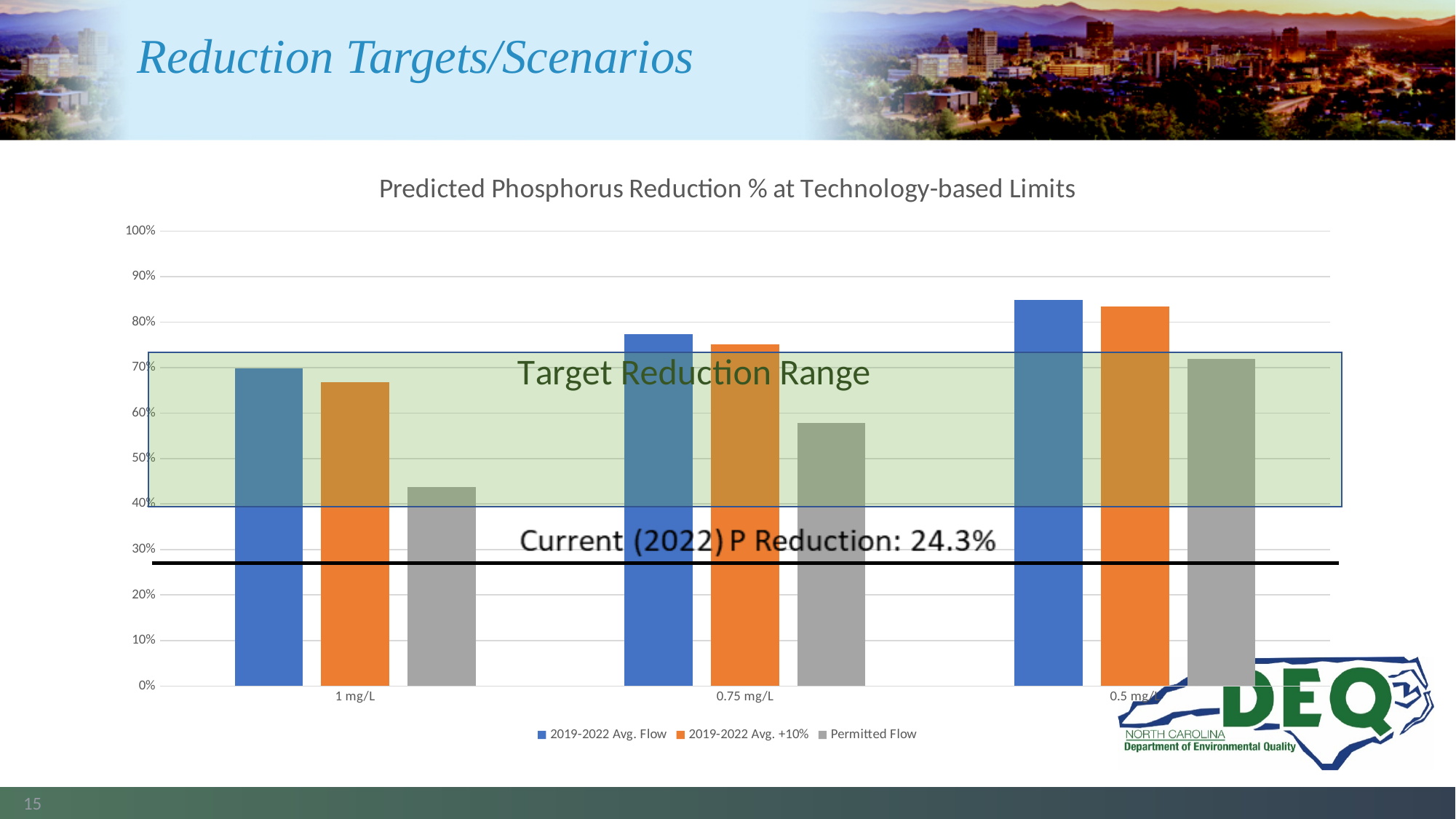
Is the Permitted Flow value at 0.5 mg/L greater or less than 60%? greater Is the 2019-2022 Avg. Flow value at 1 mg/L greater or less than 80%? less Which limit category has the highest Permitted Flow value? 0.5 mg/L Which limit category has the lowest 2019-2022 Avg. Flow value? 1 mg/L What kind of chart is shown on the slide? bar chart What current (2022) P reduction percentage is annotated on the chart? 24.3% Do the Permitted Flow values rise or fall moving from 1 mg/L to 0.5 mg/L along the x axis? rise How many limit categories are shown on the x axis? 3 How many series does the legend list? 3 Is the 2019-2022 Avg. Flow value at 0.5 mg/L greater or less than 80%? greater Which is larger: the Permitted Flow value at 1 mg/L or at 0.75 mg/L? 0.75 mg/L